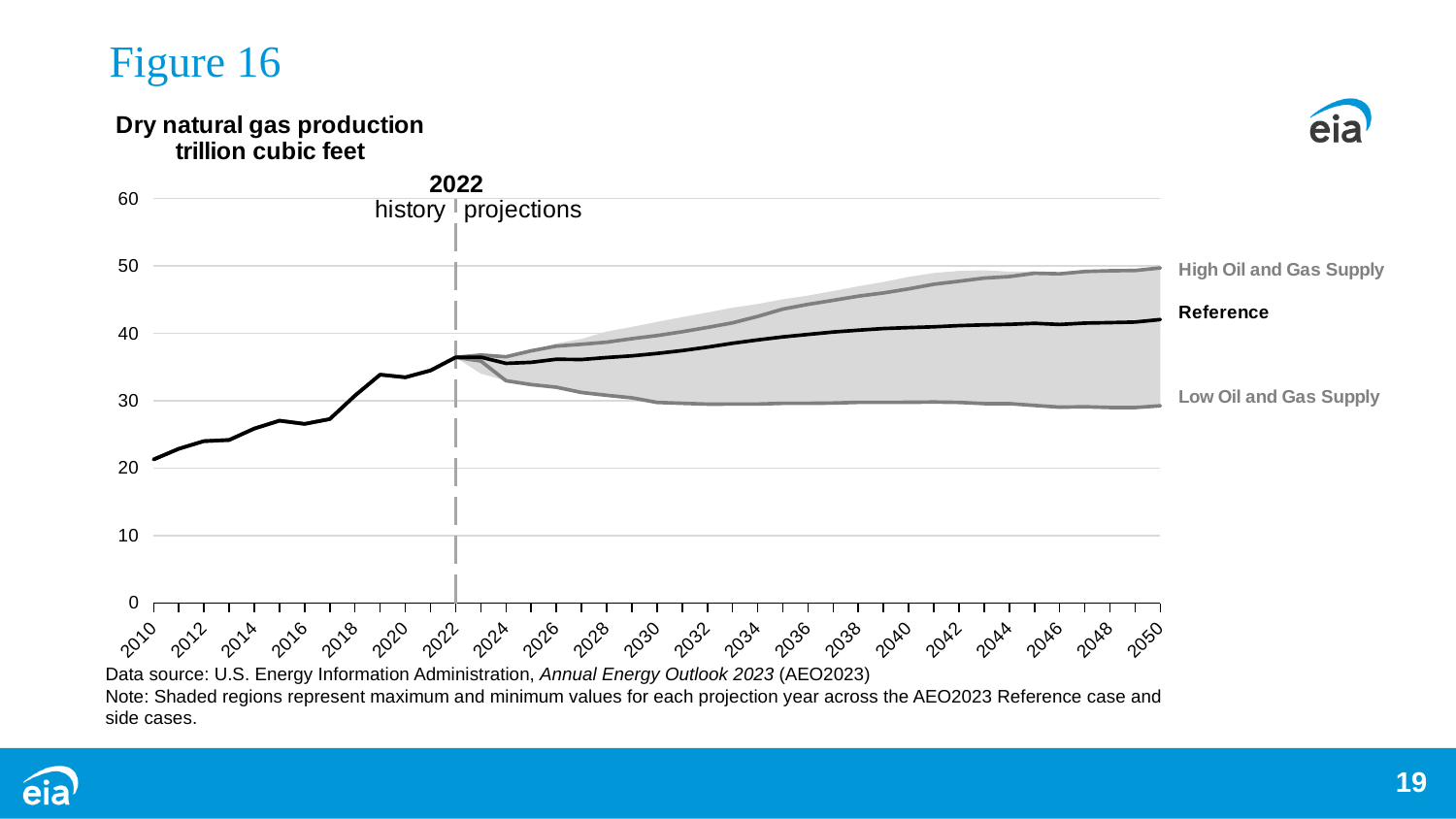
Is the Low Oil and Gas Supply value in 2050 greater or less than 40? less Is the Reference case value in 2050 greater or less than 40? greater Which series has the lowest value in 2050? Low Oil and Gas Supply In 2040, which is larger: the Reference case or the Low Oil and Gas Supply case? Reference Is the value for 2010 greater or less than 30? less In what unit is dry natural gas production measured on the chart? trillion cubic feet How many labeled projection series are shown on the chart? 3 What kind of chart is shown on the slide? line chart What is the title of the chart? Dry natural gas production Which series has the highest value in 2050? High Oil and Gas Supply Does the Reference case rise or fall from 2022 to 2050? rise